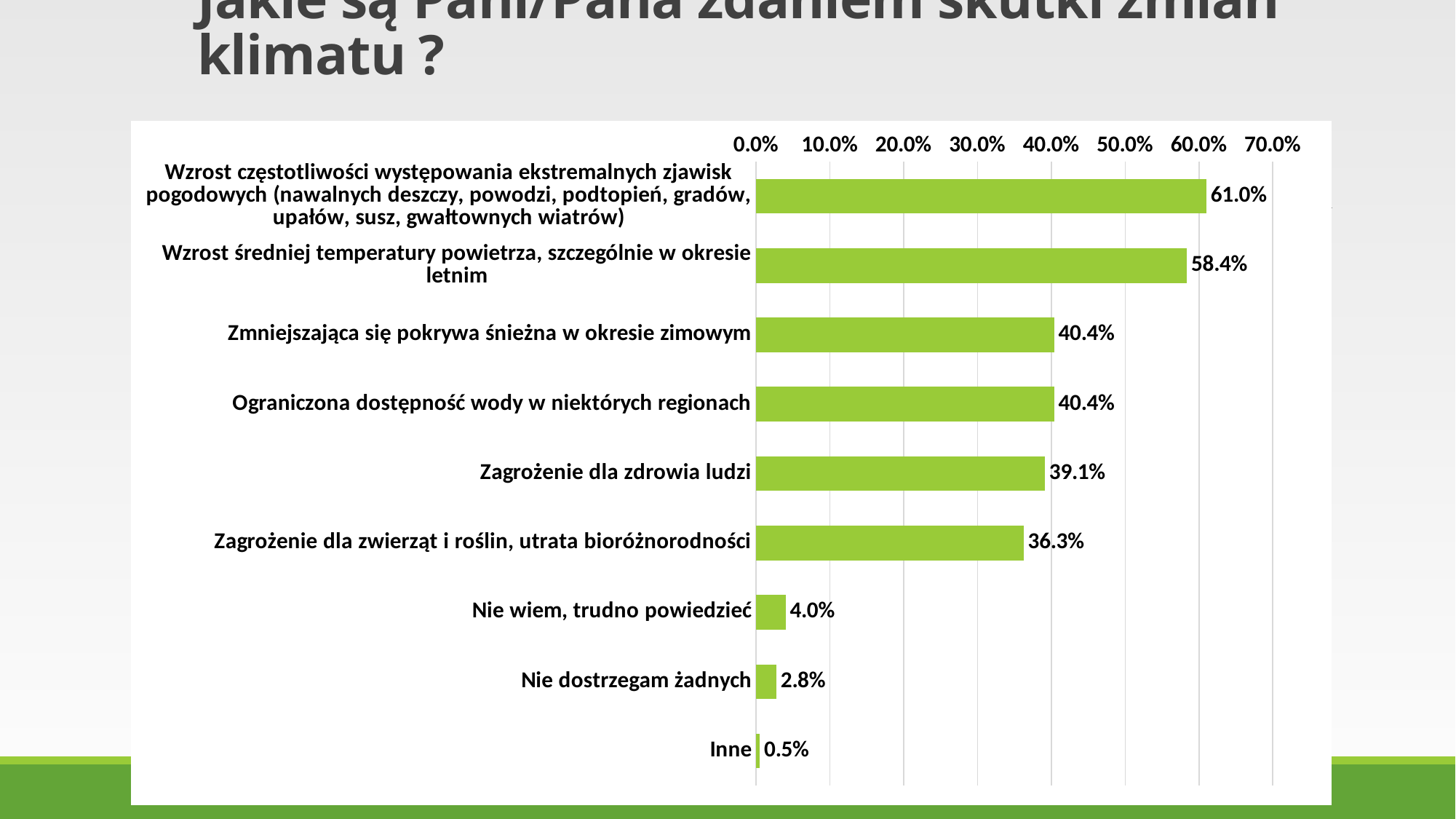
What is the value for "Nie wiem, trudno powiedzieć"? 4.0% Is the value for "Ograniczona dostępność wody w niektórych regionach" greater or less than 50.0%? less What is the highest value shown on the chart's axis? 70.0% What kind of chart is shown on the slide? bar chart How many categories are shown in the chart? 9 What is the difference between the values for "Nie wiem, trudno powiedzieć" and "Nie dostrzegam żadnych"? 1.2% Which category has the lowest value? Inne Which category has the highest value? Wzrost częstotliwości występowania ekstremalnych zjawisk pogodowych (nawalnych deszczy, powodzi, podtopień, gradów, upałów, susz, gwałtownych wiatrów) What is the value for "Zagrożenie dla zwierząt i roślin, utrata bioróżnorodności"? 36.3% What is the value for "Zagrożenie dla zdrowia ludzi"? 39.1% What is the difference between the values for "Wzrost średniej temperatury powietrza, szczególnie w okresie letnim" and "Zmniejszająca się pokrywa śnieżna w okresie zimowym"? 18.0% Which is larger: the value for "Zagrożenie dla zdrowia ludzi" or the value for "Zagrożenie dla zwierząt i roślin, utrata bioróżnorodności"? Zagrożenie dla zdrowia ludzi